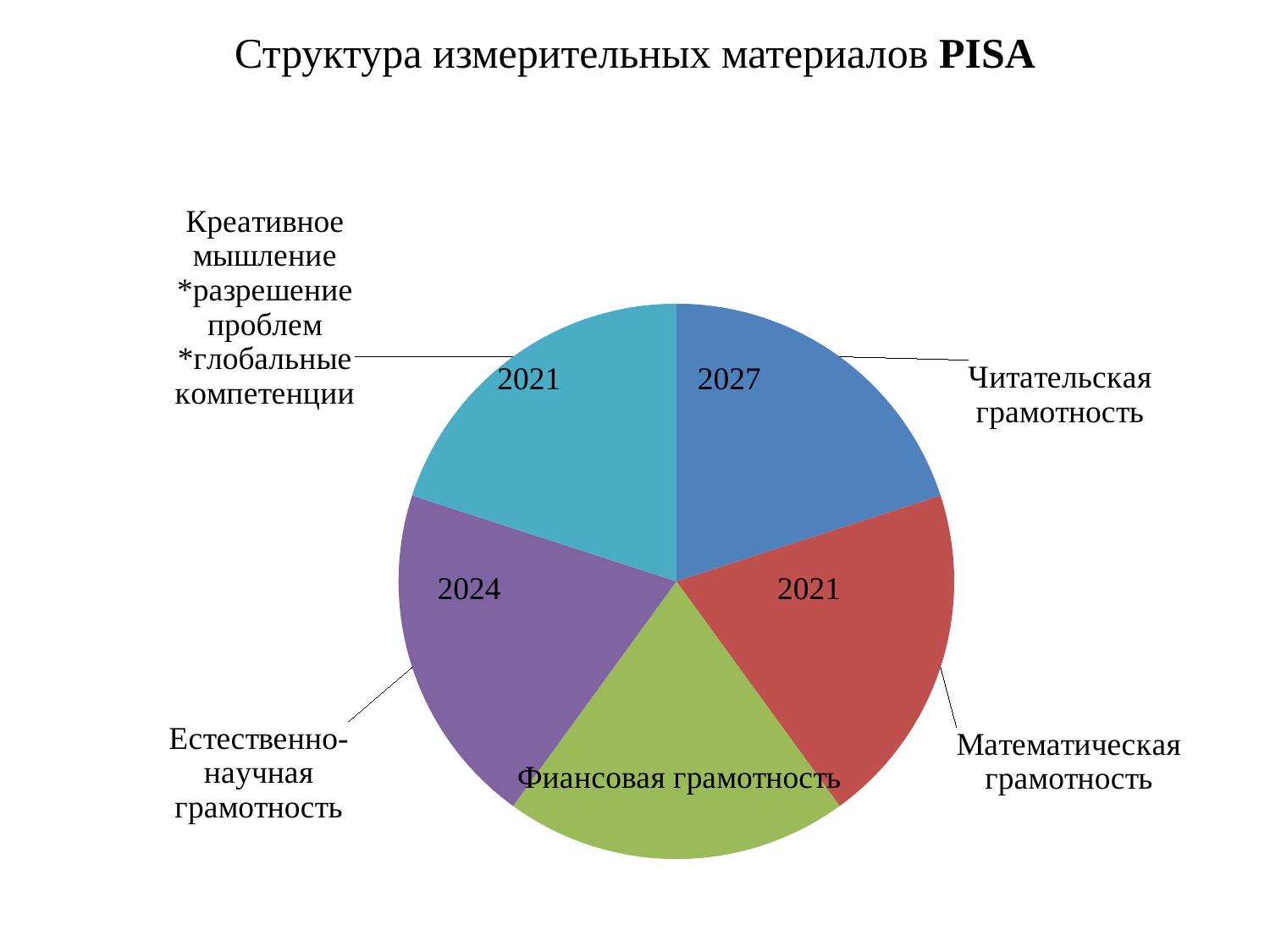
Which slice is labelled with the year 2024? Естественно-научная грамотность What year is printed inside the slice for Естественно-научная грамотность? 2024 What kind of chart is shown on the slide? pie chart How many slices does the pie chart have? 5 Which slice has its name printed inside the pie rather than a year? Фиансовая грамотность What year is printed inside the slice for Математическая грамотность? 2021 Which slice is labelled with the year 2027? Читательская грамотность What colour is the slice for Фиансовая грамотность? green What year is printed inside the slice for Читательская грамотность? 2027 What year is printed inside the slice labelled Креативное мышление? 2021 What is the title of the chart? Структура измерительных материалов PISA